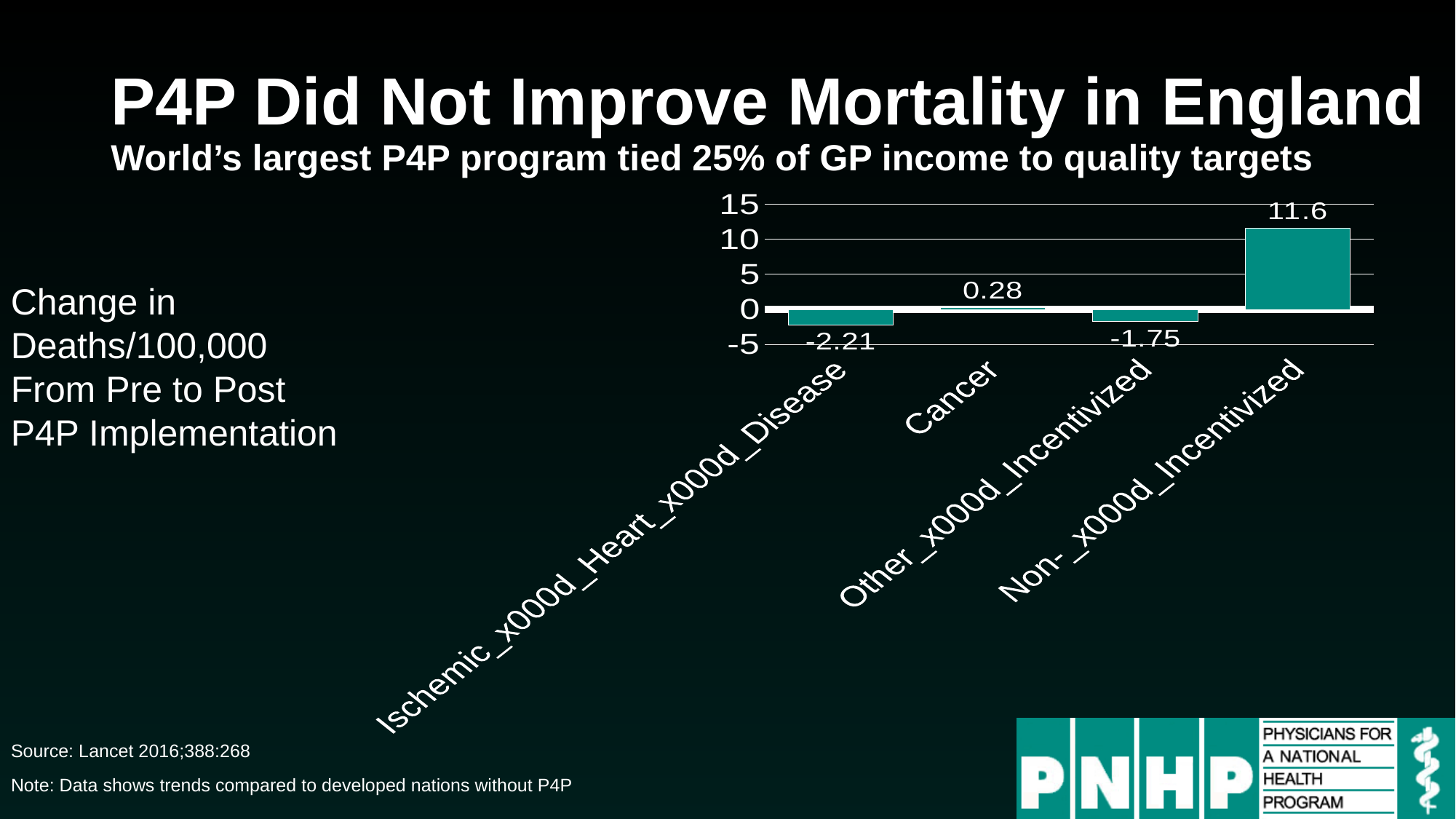
Which category has the highest change in deaths per 100,000? Non-Incentivized What is the change in deaths per 100,000 for Cancer? 0.28 What is the difference between the Non-Incentivized value and the Cancer value? 11.32 What kind of chart is shown on the slide? bar chart What is the change in deaths per 100,000 for Non-Incentivized conditions? 11.6 Is the value for Non-Incentivized greater or less than 10? greater How many categories are shown in the chart? 4 What is the change in deaths per 100,000 for Other Incentivized conditions? -1.75 Which category has the lowest change in deaths per 100,000? Ischemic Heart Disease What is the change in deaths per 100,000 for Ischemic Heart Disease? -2.21 What colour are the bars in the chart? teal Which is larger, the value for Cancer or the value for Other Incentivized? Cancer